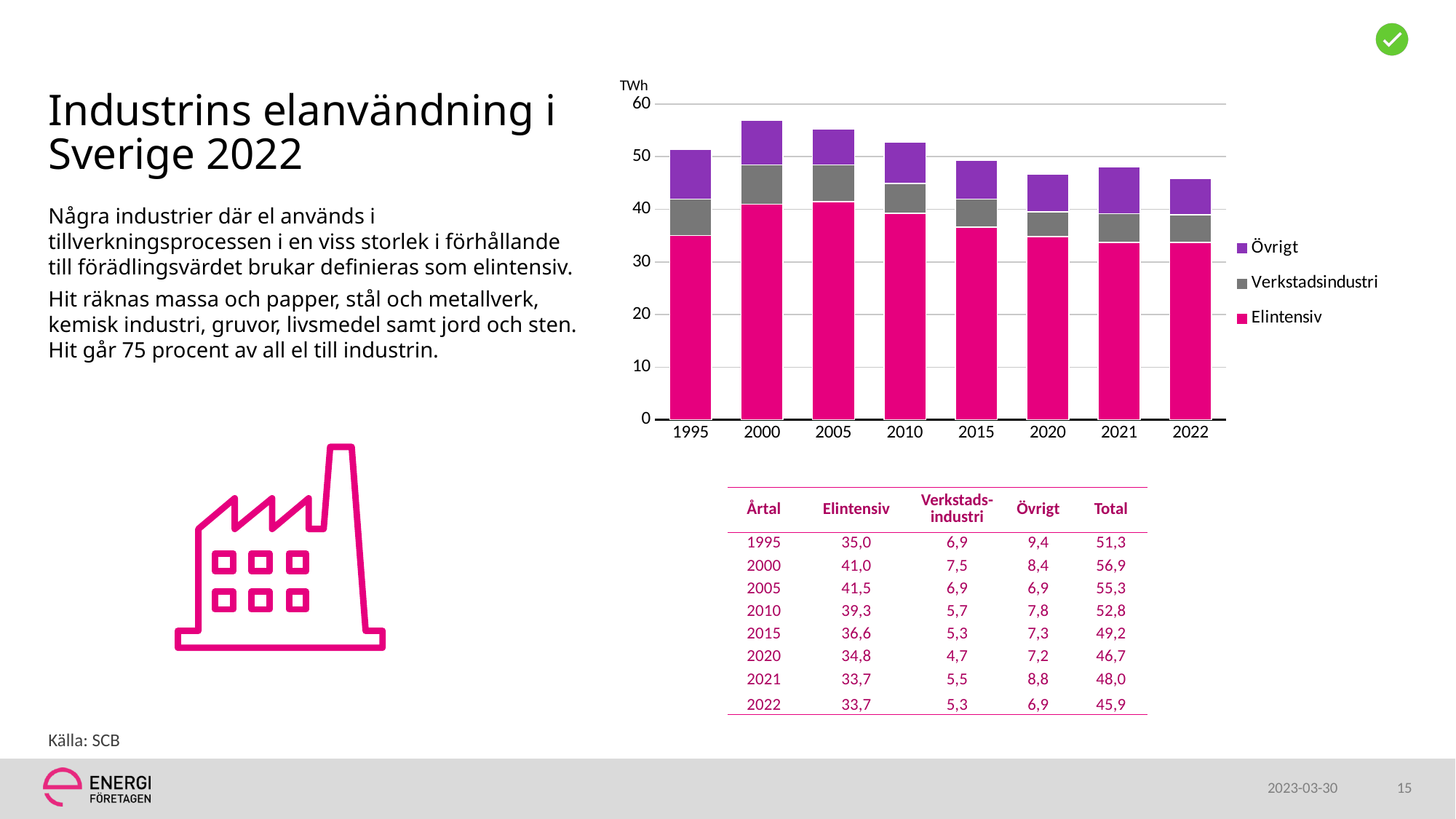
Is the total for 2000 greater or less than 50? greater Which year has the lowest total? 2022 What kind of chart is shown on the slide? Stacked bar chart Do the total values rise or fall from 2000 to 2022? Fall What is the difference between the Elintensiv value in 2005 and in 2022? 7,8 What is the Elintensiv value for 2000? 41,0 What unit is shown on the y axis of the chart? TWh How many series does the chart legend list? 3 How many years are shown on the x axis of the chart? 8 What is the total electricity use for 2022? 45,9 Which year has the larger Övrigt value, 2021 or 2022? 2021 Which year has the highest total? 2000